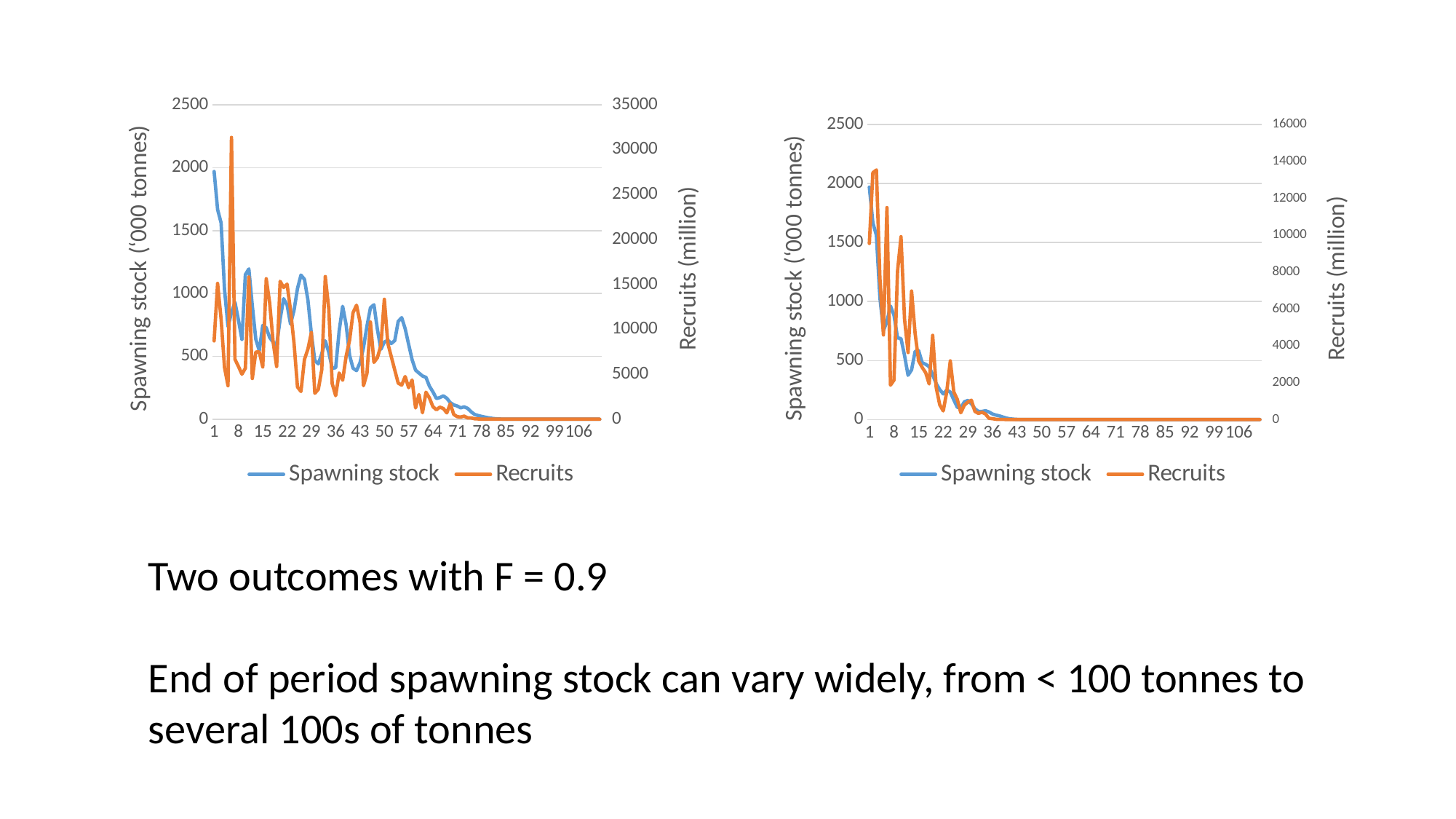
In the right chart, does the Recruits series generally rise or fall along the x axis? fall In the left chart, does the Spawning stock series generally rise or fall along the x axis? fall In the right chart, is the peak Recruits value greater or less than 12000? greater How many series does the legend of the right chart list? 2 In the left chart, is the peak Recruits value greater or less than 25000? greater In the left chart, which is larger: the Spawning stock value at x = 1 or at x = 106? x = 1 In the right chart, is the Spawning stock value at x = 50 greater or less than 500? less What kind of chart is the left chart on the slide? line chart What is the title of the left-hand vertical axis on the right chart? Spawning stock ('000 tonnes) What is the title of the right-hand vertical axis on the left chart? Recruits (million)